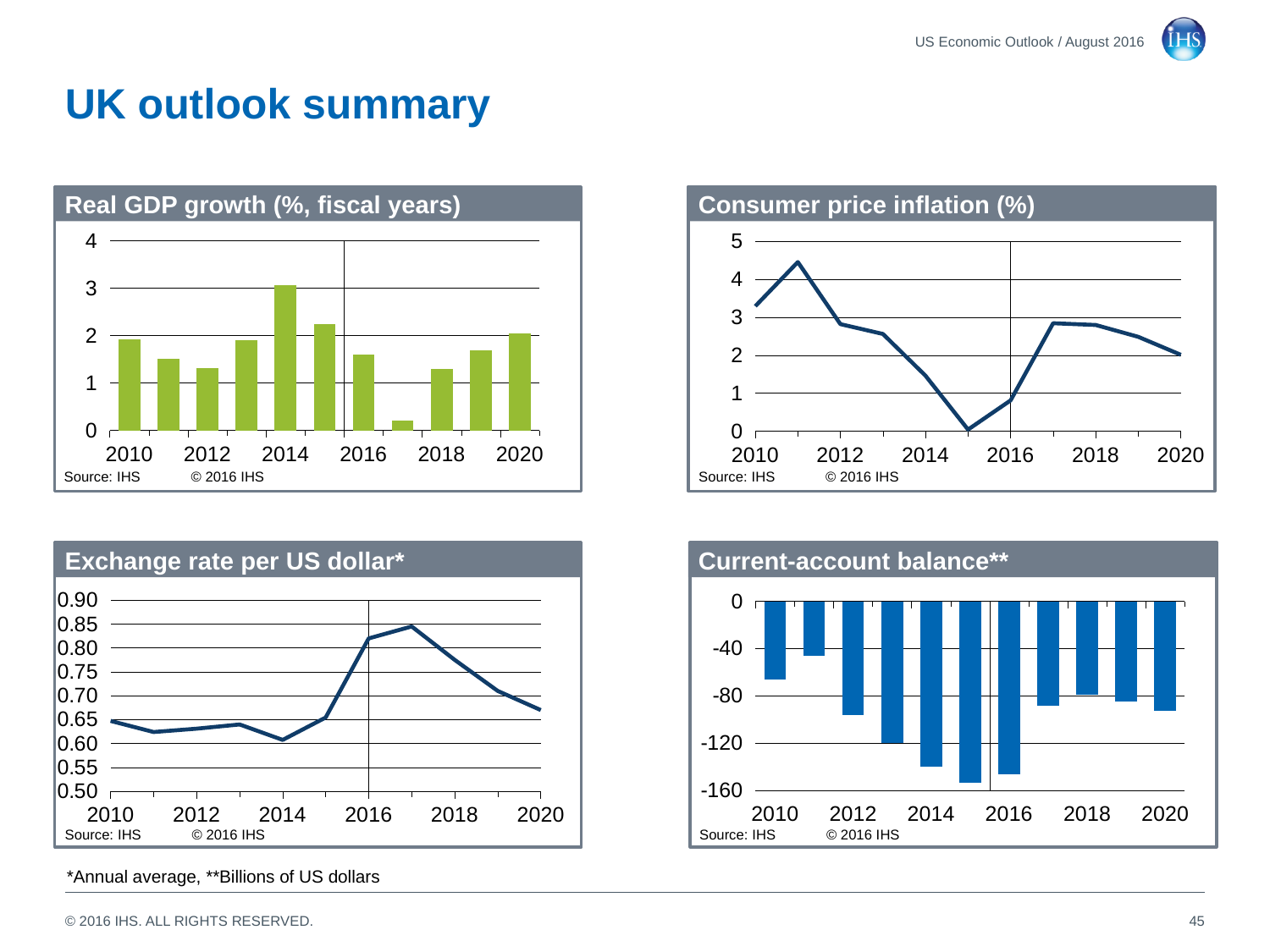
How many bars are plotted in the 'Current-account balance**' chart? 11 In the 'Real GDP growth (%, fiscal years)' chart, which year has the highest bar? 2014 In the 'Exchange rate per US dollar*' chart, which year has the highest value? 2017 In the 'Consumer price inflation (%)' chart, which year has the highest value? 2011 In the 'Real GDP growth (%, fiscal years)' chart, is the value for 2017 greater or less than 1? less In the 'Consumer price inflation (%)' chart, is the value for 2011 greater or less than 4? greater In the 'Current-account balance**' chart, which year has the lowest (most negative) value? 2015 In the 'Exchange rate per US dollar*' chart, is the value for 2014 greater or less than 0.65? less What kind of chart is the 'Real GDP growth (%, fiscal years)' chart? bar chart What kind of chart is the 'Consumer price inflation (%)' chart? line chart In the 'Consumer price inflation (%)' chart, do values rise or fall from 2011 to 2015? fall In the 'Real GDP growth (%, fiscal years)' chart, which year has the lowest bar? 2017